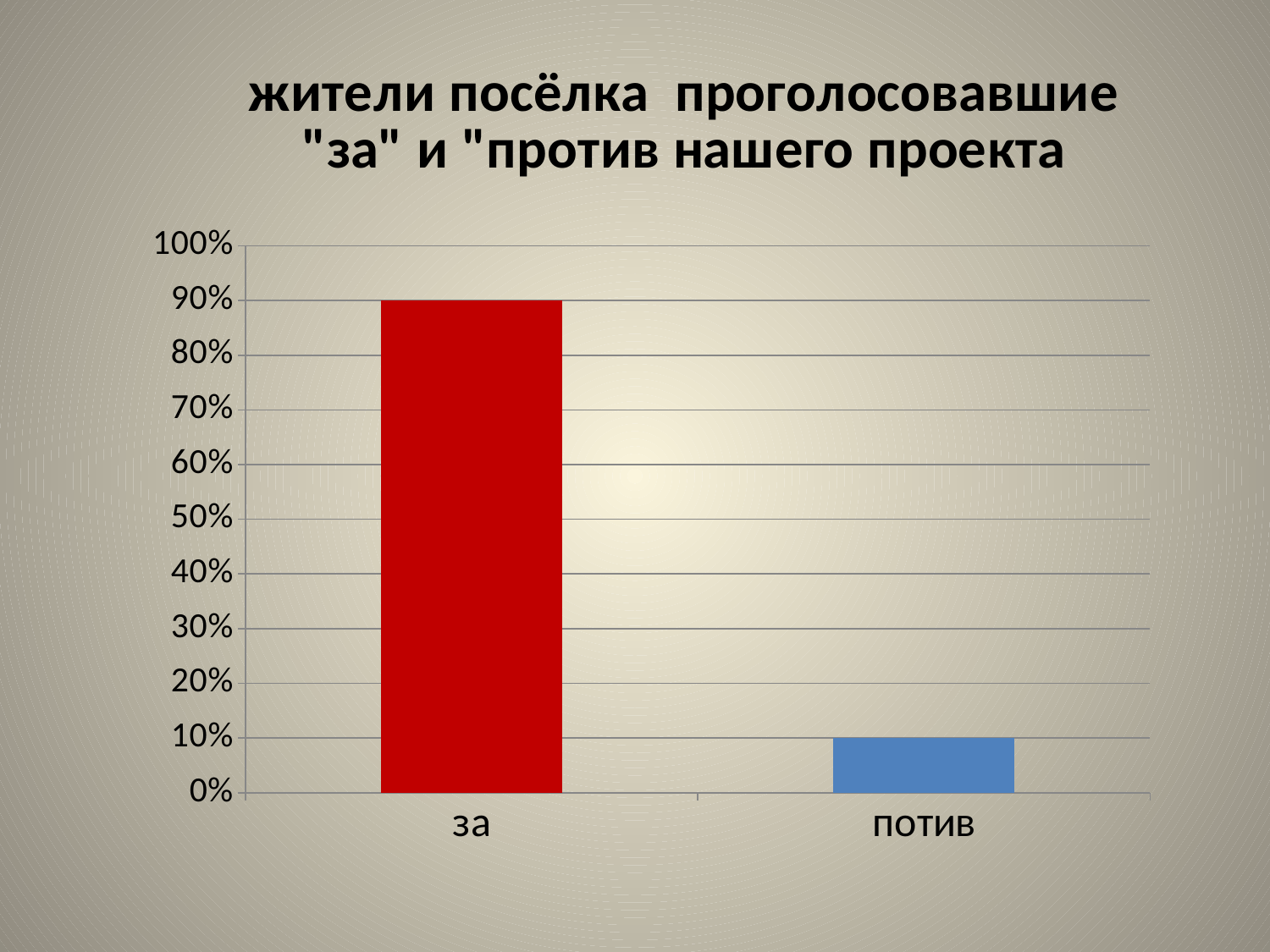
What is the value for "за"? 90% How many categories are shown on the x axis? 2 What kind of chart is shown on the slide? bar chart Which category has the highest value? за What is the maximum value shown on the vertical axis? 100% Which category has the lowest value? потив Which is larger, the value for "за" or the value for "потив"? за What is the difference between the values for "за" and "потив"? 80% Is the value for "за" greater or less than 50%? greater Is the value for "потив" greater or less than 20%? less What colour is the bar for "за"? red What is the value for "потив"? 10%